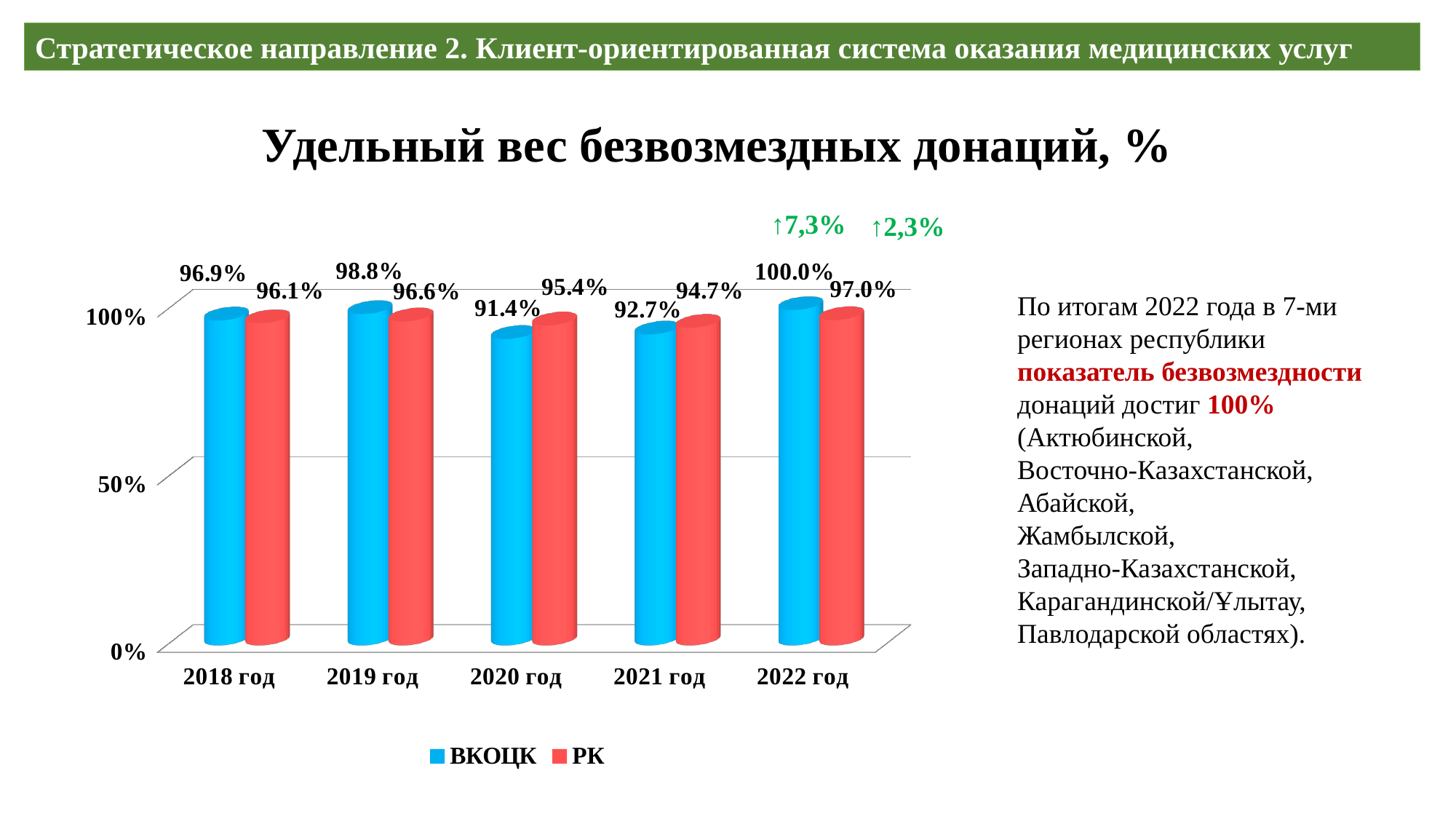
In which year is the РК value the highest? 2022 год In which year is the ВКОЦК value the lowest? 2020 год How many years are shown on the x axis? 5 What is the value for ВКОЦК in 2018 год? 96.9% What kind of chart is shown on the slide? bar chart What is the value for ВКОЦК in 2022 год? 100.0% What is the title of the chart? Удельный вес безвозмездных донаций, % What is the value for РК in 2021 год? 94.7% What is the difference between the ВКОЦК and РК values in 2020 год? 4.0% How many series does the legend list? 2 Which is larger in 2019 год, the ВКОЦК value or the РК value? ВКОЦК What is the value for РК in 2020 год? 95.4%